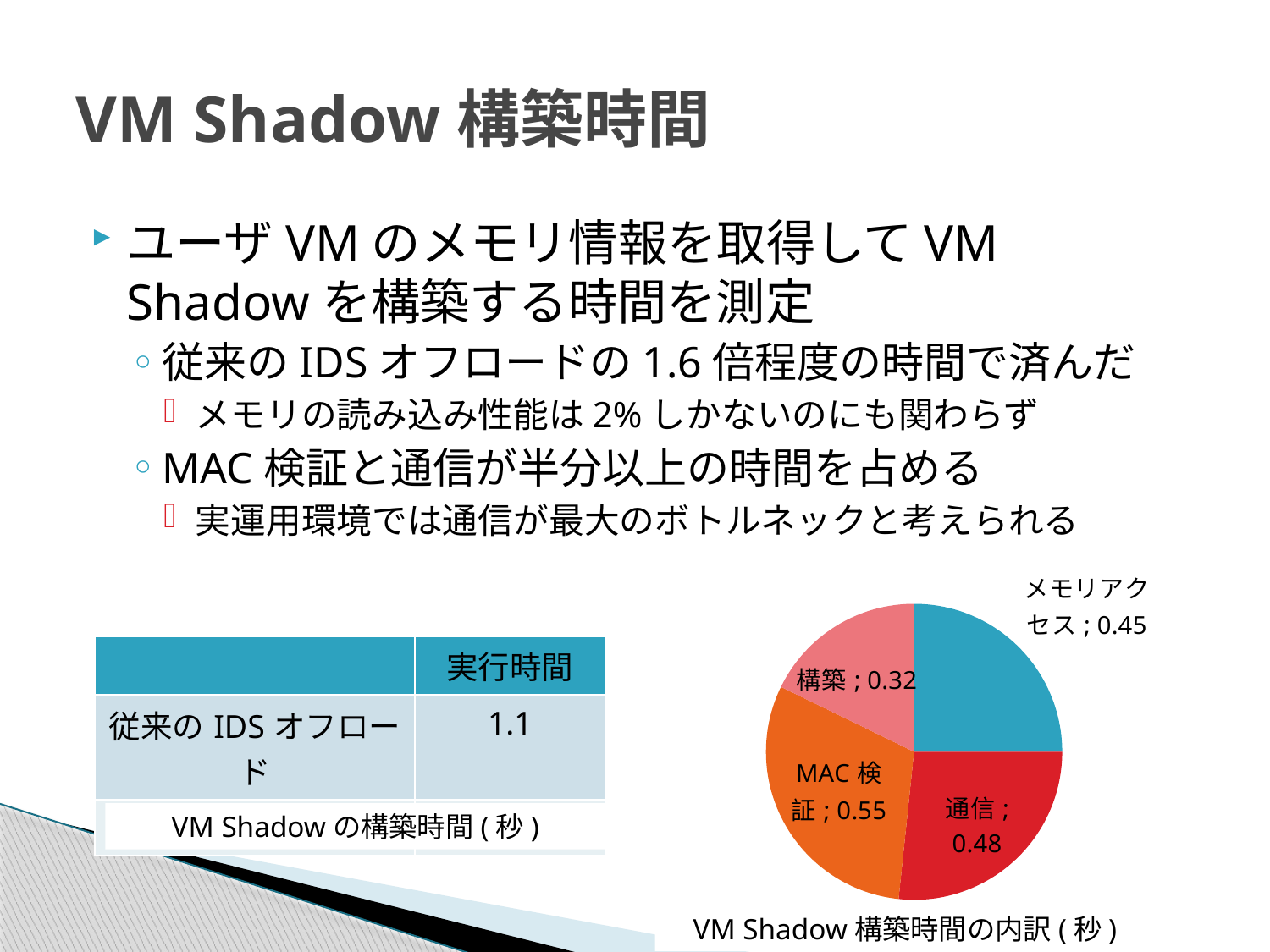
In the pie chart, what is the value for 通信? 0.48 In the pie chart, what is the value for メモリアクセス? 0.45 How many slices does the pie chart have? 4 What is the sum of all four values shown in the pie chart? 1.8 What kind of chart is shown at the bottom right of the slide? Pie chart Which slice of the pie chart has the largest value? MAC 検証 Which slice of the pie chart has the smallest value? 構築 In the pie chart, what is the value for 構築? 0.32 In the pie chart, which is larger: the value for 通信 or the value for メモリアクセス? 通信 In the pie chart, what is the value for MAC 検証? 0.55 What is the caption written below the pie chart? VM Shadow 構築時間の内訳 ( 秒 ) In the pie chart, what is the difference between the values for MAC 検証 and 構築? 0.23